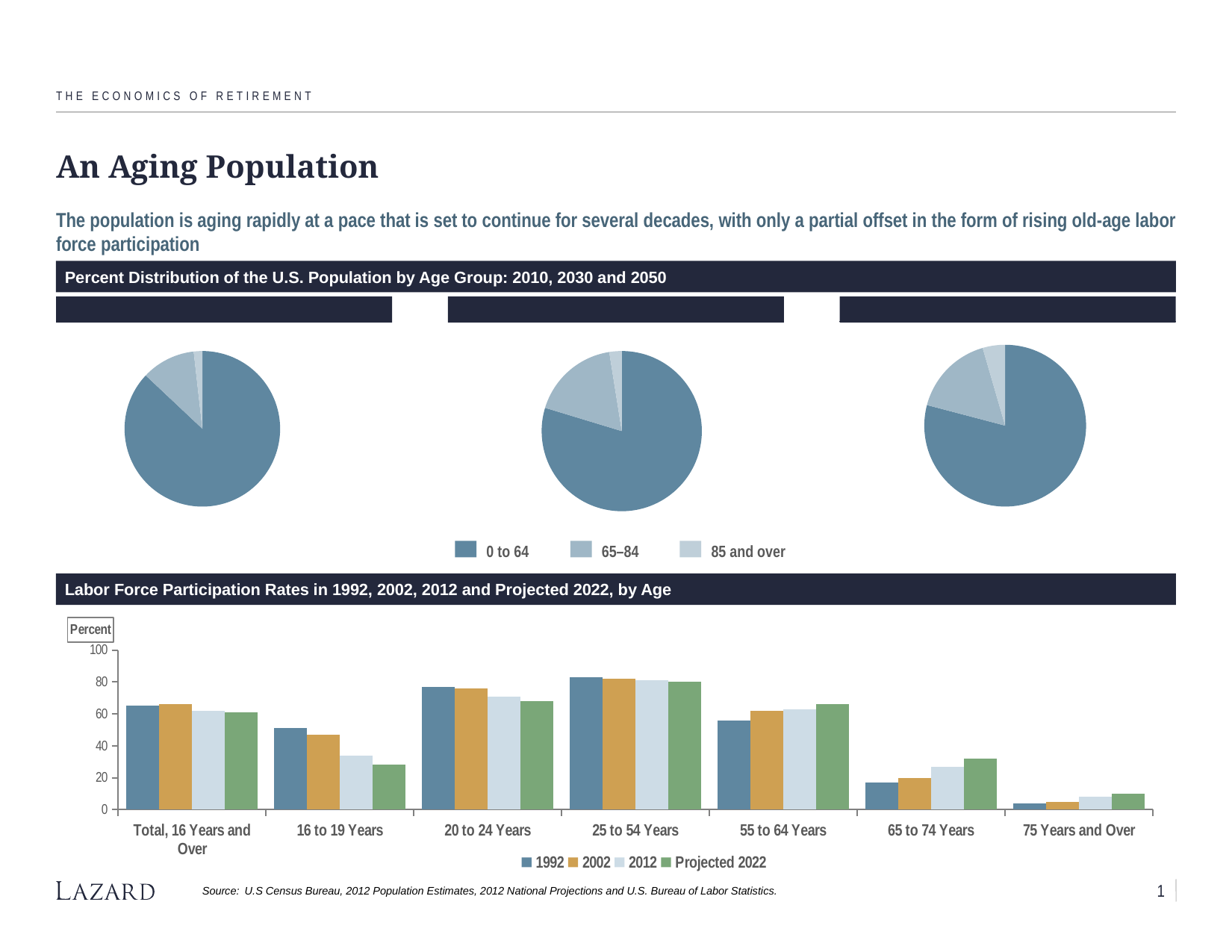
In the pie charts under 'Percent Distribution of the U.S. Population by Age Group', how many age groups does the legend list? 3 In the 'Labor Force Participation Rates' bar chart, do the values for 65 to 74 Years rise or fall from 1992 to Projected 2022? rise In the 'Labor Force Participation Rates' bar chart, is the Projected 2022 value for 16 to 19 Years greater or less than 40? less In the 'Labor Force Participation Rates' bar chart, do the values for 16 to 19 Years rise or fall from 1992 to Projected 2022? fall In the 'Labor Force Participation Rates' bar chart, which age category has the highest participation rates? 25 to 54 Years In the 'Labor Force Participation Rates' bar chart, which is larger for 16 to 19 Years: the 1992 value or the Projected 2022 value? 1992 In the 'Labor Force Participation Rates' bar chart, is the Projected 2022 value for 65 to 74 Years greater or less than 20? greater How many age categories are shown on the x axis of the 'Labor Force Participation Rates' bar chart? 7 How many series does the legend of the 'Labor Force Participation Rates' bar chart list? 4 What kind of chart is the chart titled 'Labor Force Participation Rates in 1992, 2002, 2012 and Projected 2022, by Age'? Bar chart In the 'Labor Force Participation Rates' bar chart, which age category has the lowest participation rates? 75 Years and Over In the 'Labor Force Participation Rates' bar chart, is the 1992 value for 75 Years and Over greater or less than 20? less